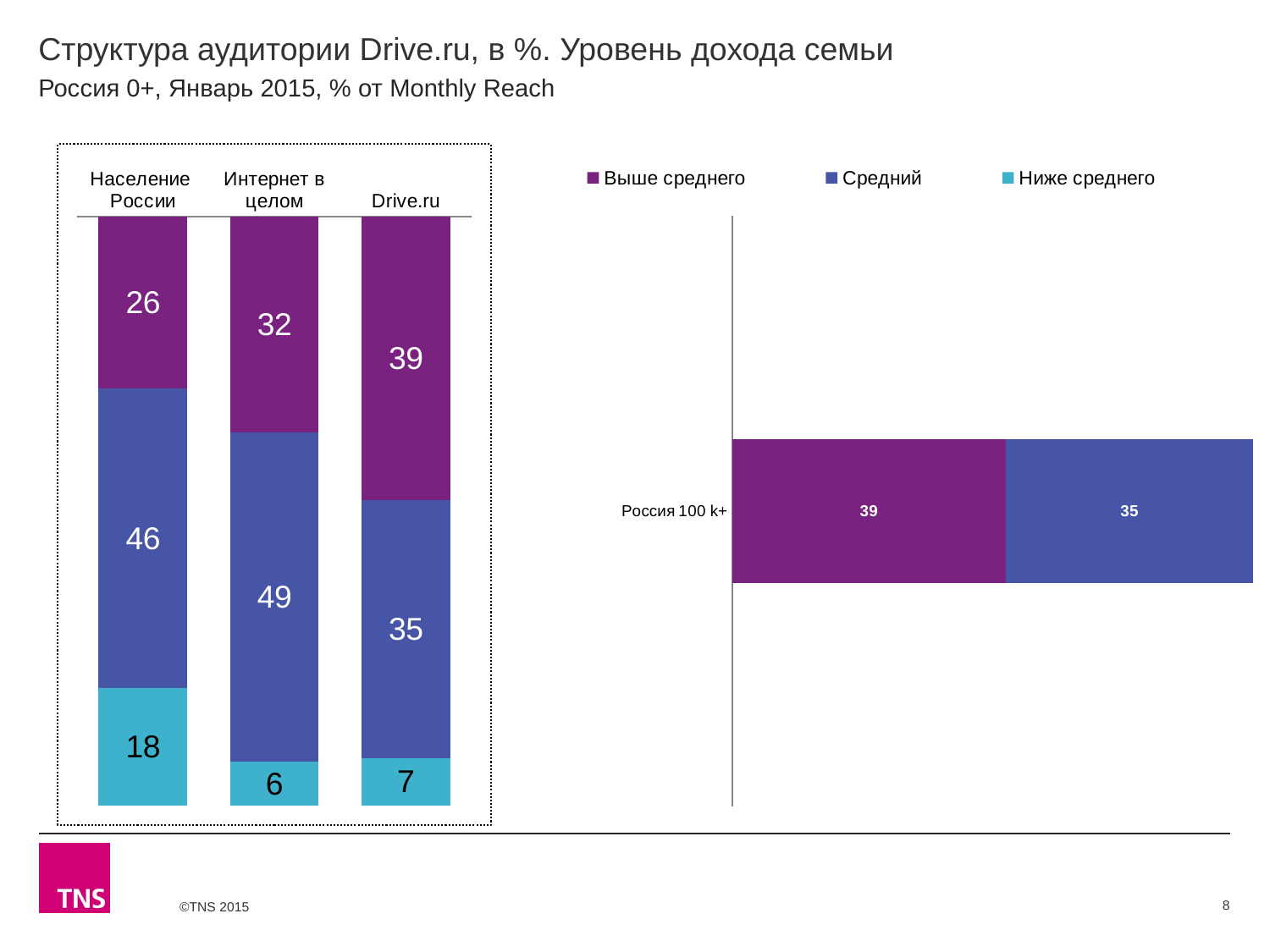
In the left stacked bar chart, which is larger: the 'Средний' value for Население России or for Drive.ru? Население России In the left stacked bar chart, what is the difference between the 'Выше среднего' values for Drive.ru and Население России? 13 In the left stacked bar chart, what is the value of the 'Выше среднего' segment for Drive.ru? 39 In the left stacked bar chart, what is the value of the 'Ниже среднего' segment for Население России? 18 How many series does the legend list? 3 What kind of chart is the chart on the right of the slide? Bar chart In the right chart, what is the 'Средний' value for Россия 100 k+? 35 In the left stacked bar chart, which category has the lowest 'Ниже среднего' value? Интернет в целом In the left stacked bar chart, what is the total of the stacked bar for Drive.ru? 81 In the left stacked bar chart, which category has the highest 'Выше среднего' value? Drive.ru In the left stacked bar chart, what is the value of the 'Средний' segment for Интернет в целом? 49 How many categories are shown in the left stacked bar chart? 3